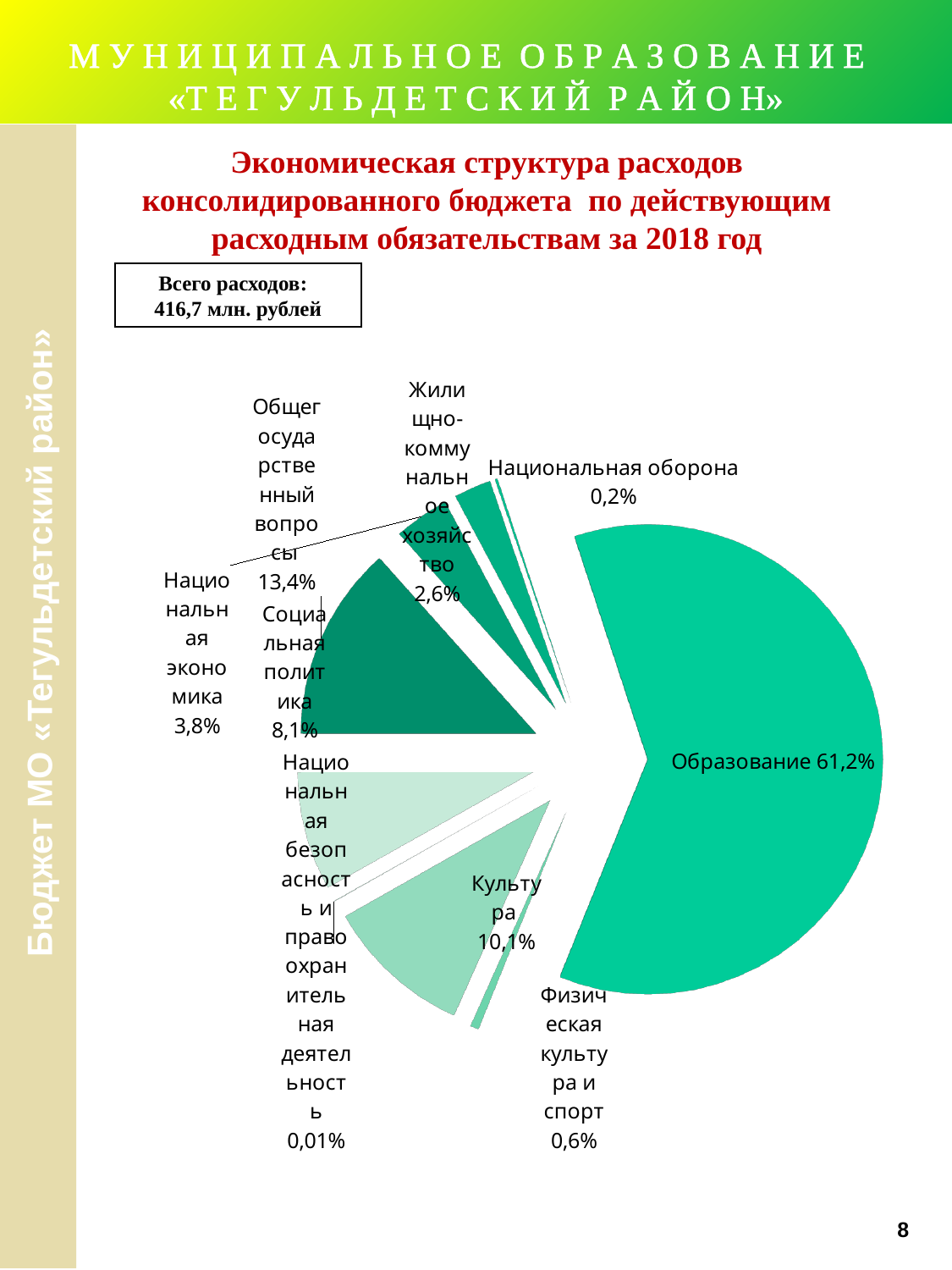
What is the value shown for Культура? 10,1% What is the value shown for Физическая культура и спорт? 0,6% What share of expenditures does Образование account for? 61,2% What is the value shown for Национальная оборона? 0,2% Which category has the smallest slice of the pie? Национальная безопасность и правоохранительная деятельность What is the value shown for Общегосударственные вопросы? 13,4% Which is larger, the share for Национальная экономика or the share for Жилищно-коммунальное хозяйство? Национальная экономика What is the difference between the shares for Общегосударственные вопросы and Культура? 3,3% What is the value shown for Социальная политика? 8,1% What kind of chart is shown on the slide? pie chart Which category has the largest slice of the pie? Образование How many categories are shown in the pie chart? 9